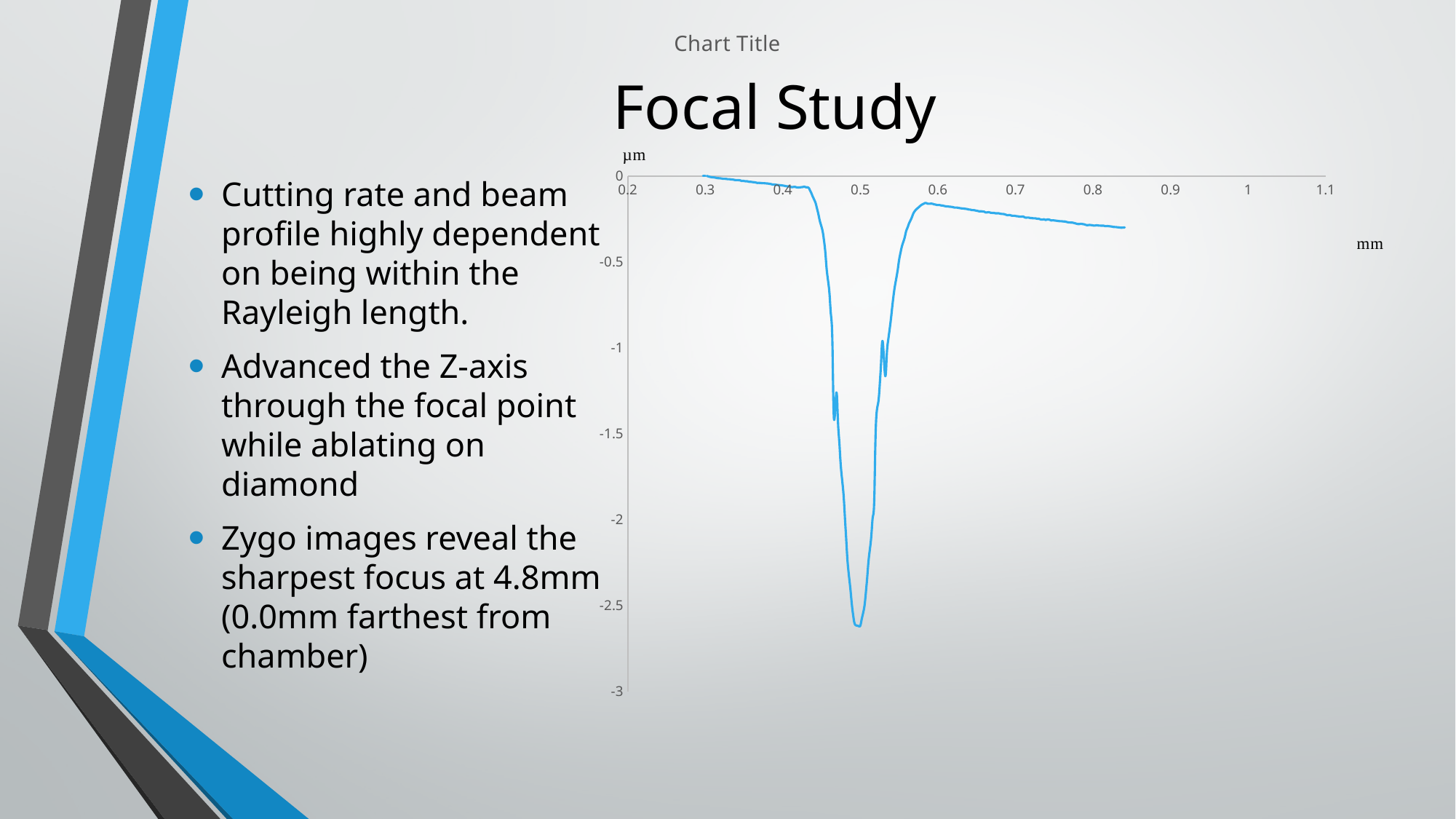
What unit label is shown on the vertical axis of the chart? µm What is the title printed above the chart? Chart Title What kind of chart is shown on the slide? line chart Is the lowest point of the line greater or less than -2? less Do the values rise or fall as x increases from 0.6 to 0.8? fall Is the value of the line at x = 0.7 greater or less than -0.5? greater Do the values rise or fall as x increases from 0.5 to 0.6? rise Is the lowest point of the line greater or less than -3? greater What is the lowest tick value shown on the vertical axis? -3 Which is larger, the value of the line at x = 0.3 or the value at x = 0.5? x = 0.3